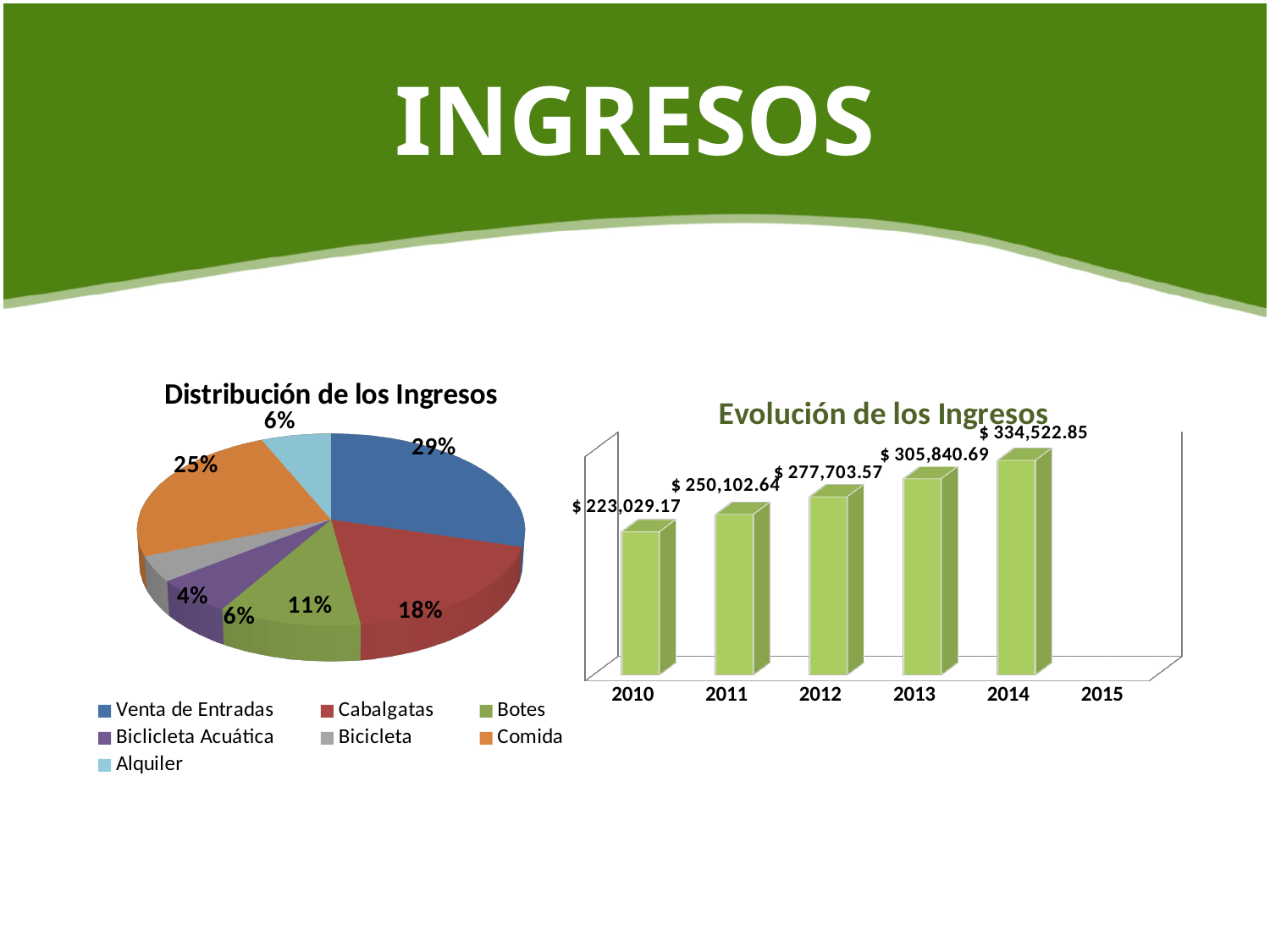
In the 'Distribución de los Ingresos' pie chart, which category has the smallest share? Bicicleta In the 'Distribución de los Ingresos' pie chart, what share does Comida have? 25% What kind of chart is 'Evolución de los Ingresos'? bar chart In the 'Evolución de los Ingresos' chart, what is the difference between the 2014 and 2010 values? $ 111,493.68 In the 'Evolución de los Ingresos' chart, which year has the highest value? 2014 In the 'Evolución de los Ingresos' chart, do the values rise or fall from 2010 to 2014? rise In the 'Evolución de los Ingresos' chart, what is the value for 2010? $ 223,029.17 In the 'Evolución de los Ingresos' chart, what is the value for 2014? $ 334,522.85 In the 'Distribución de los Ingresos' pie chart, what is the difference in percentage points between Venta de Entradas and Comida? 4% In the 'Distribución de los Ingresos' pie chart, what share does Venta de Entradas have? 29% In the 'Distribución de los Ingresos' pie chart, how many categories does the legend list? 7 In the 'Distribución de los Ingresos' pie chart, which category has the largest share? Venta de Entradas